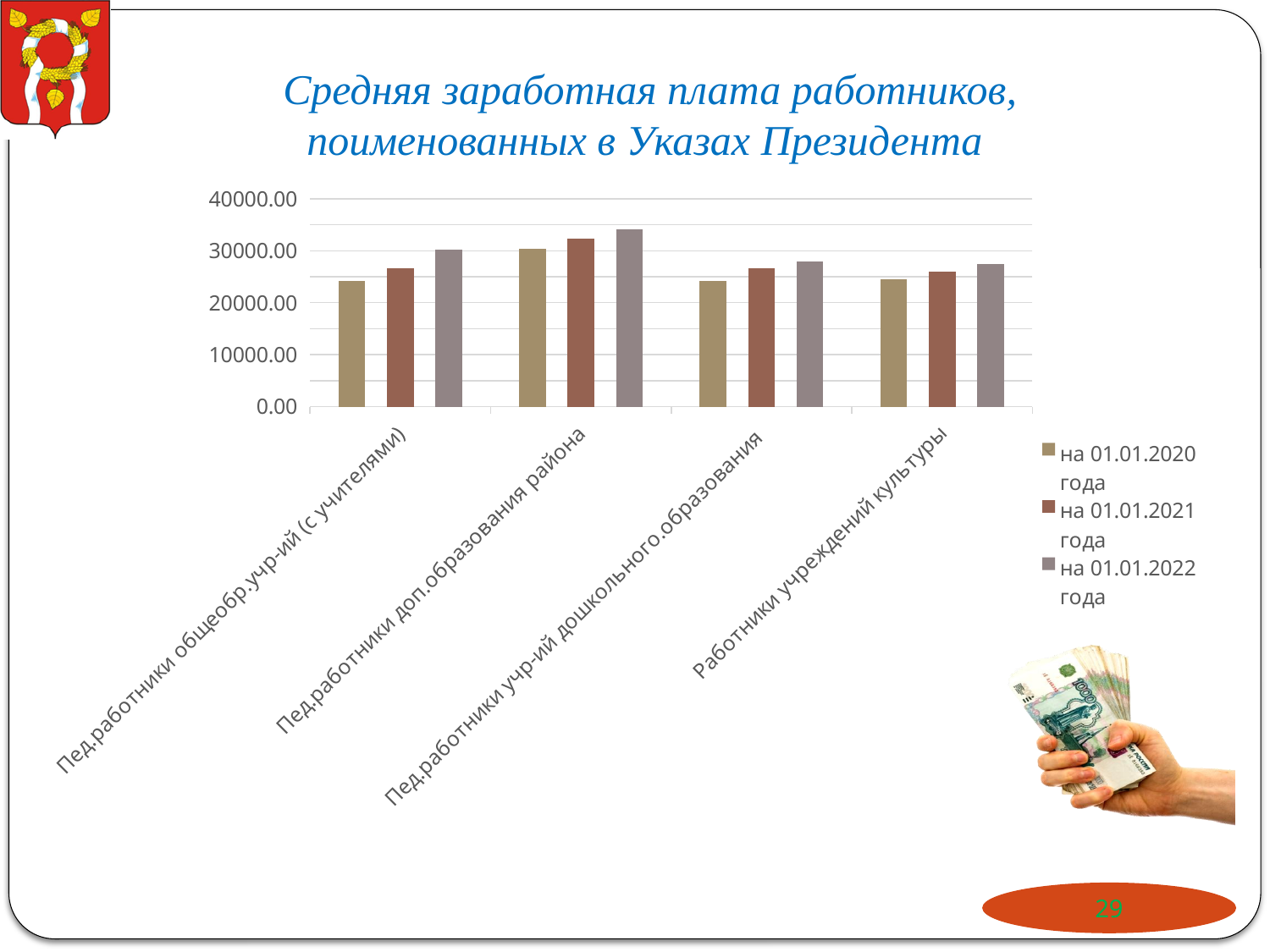
How many series does the chart legend list? 3 Which series does the legend list first? на 01.01.2020 года Is the value for 'Пед.работники доп.образования района' in the series 'на 01.01.2022 года' greater or less than 30000.00? greater For the series 'на 01.01.2022 года', which is larger: the value for 'Пед.работники доп.образования района' or for 'Работники учреждений культуры'? Пед.работники доп.образования района How many categories of workers are shown on the x axis of the chart? 4 Is the value for 'Работники учреждений культуры' in the series 'на 01.01.2020 года' greater or less than 20000.00? greater What is the title of the chart on the slide? Средняя заработная плата работников, поименованных в Указах Президента What kind of chart is shown on the slide? bar chart Within each category, do the values rise or fall from 'на 01.01.2020 года' to 'на 01.01.2022 года'? rise Is the value for 'Пед.работники общеобр.учр-ий (с учителями)' in the series 'на 01.01.2020 года' greater or less than 30000.00? less Which category has the highest value for the series 'на 01.01.2022 года'? Пед.работники доп.образования района